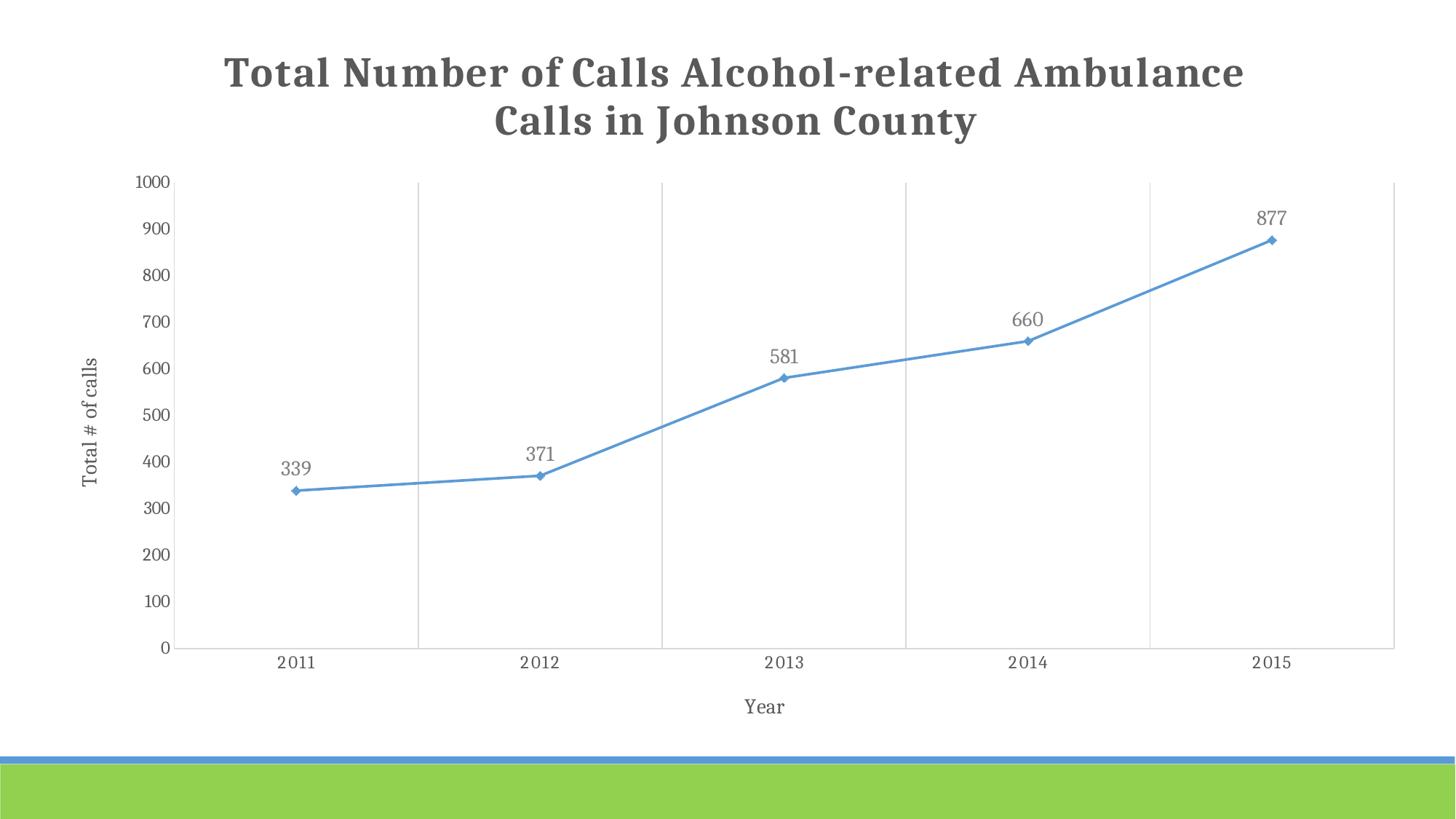
What is the difference in the number of calls between 2012 and 2011? 32 What kind of chart is shown on the slide? line chart What is the difference in the number of calls between 2015 and 2014? 217 What is the total number of calls in 2013? 581 How many years are plotted on the chart? 5 What is the total number of calls in 2015? 877 Which year had more calls, 2013 or 2014? 2014 Which year has the lowest number of calls? 2011 What is the total number of calls in 2011? 339 Is the value for 2014 greater or less than 700? less Do the values rise or fall from 2011 to 2015? rise Which year has the highest number of calls? 2015